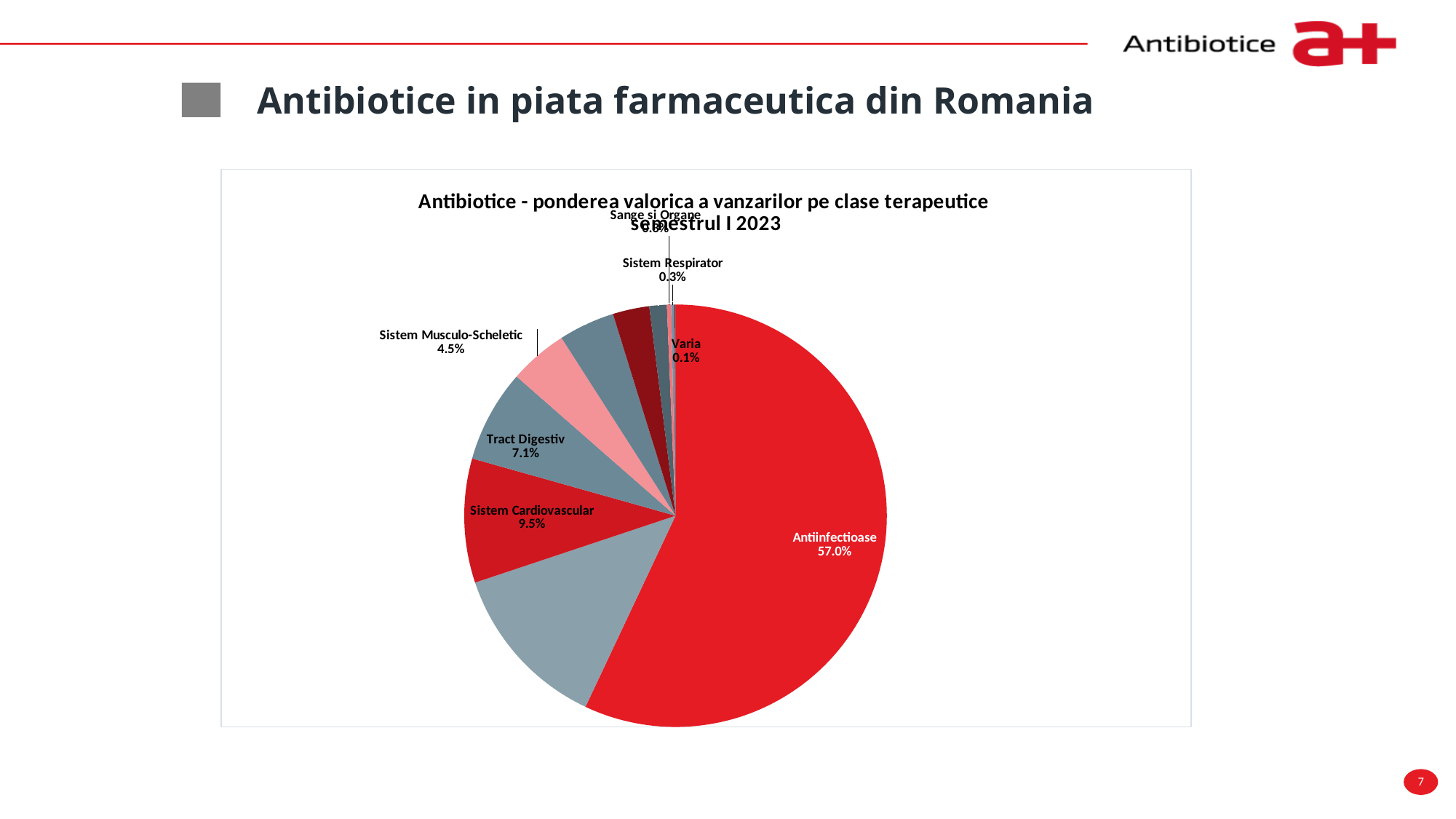
What is the value shown for Varia? 0.1% Which therapeutic class has the largest share of sales? Antiinfectioase Which is larger, the share for Tract Digestiv or for Sistem Musculo-Scheletic? Tract Digestiv What share of sales does the Antiinfectioase slice represent? 57.0% What is the value shown for Sistem Musculo-Scheletic? 4.5% By how many percentage points does Sistem Cardiovascular exceed Tract Digestiv? 2.4 percentage points What period does the chart title say the data covers? Semestrul I 2023 What kind of chart is shown on the slide? Pie chart Which labelled therapeutic class has the smallest share of sales? Varia What is the value shown for Sistem Respirator? 0.3% What is the value shown for Sistem Cardiovascular? 9.5% What is the value shown for Tract Digestiv? 7.1%